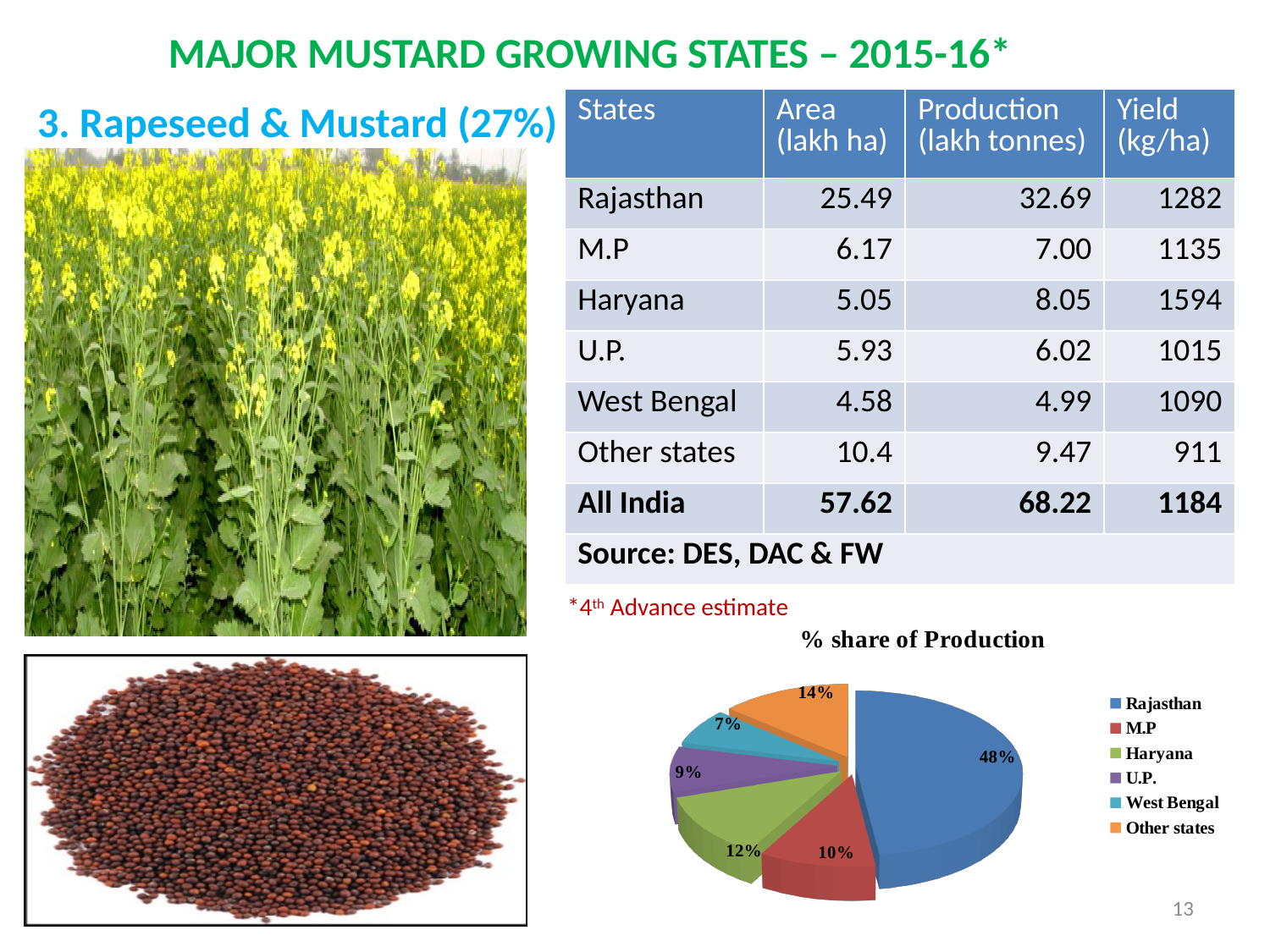
In the '% share of Production' pie chart, what share does West Bengal have? 7% How many entries does the legend of the '% share of Production' pie chart list? 6 What kind of chart is shown under the title '% share of Production'? pie chart In the '% share of Production' pie chart, what is the difference between Rajasthan's share and M.P's share? 38% In the '% share of Production' pie chart, which state has the largest share? Rajasthan In the '% share of Production' pie chart, what share do Other states have? 14% In the '% share of Production' pie chart, which has the larger share, Haryana or U.P.? Haryana What is the title of the pie chart on the slide? % share of Production In the '% share of Production' pie chart, which state has the smallest share? West Bengal In the '% share of Production' pie chart, what share does Rajasthan have? 48% How many slices does the '% share of Production' pie chart have? 6 In the '% share of Production' pie chart, what share does Haryana have? 12%